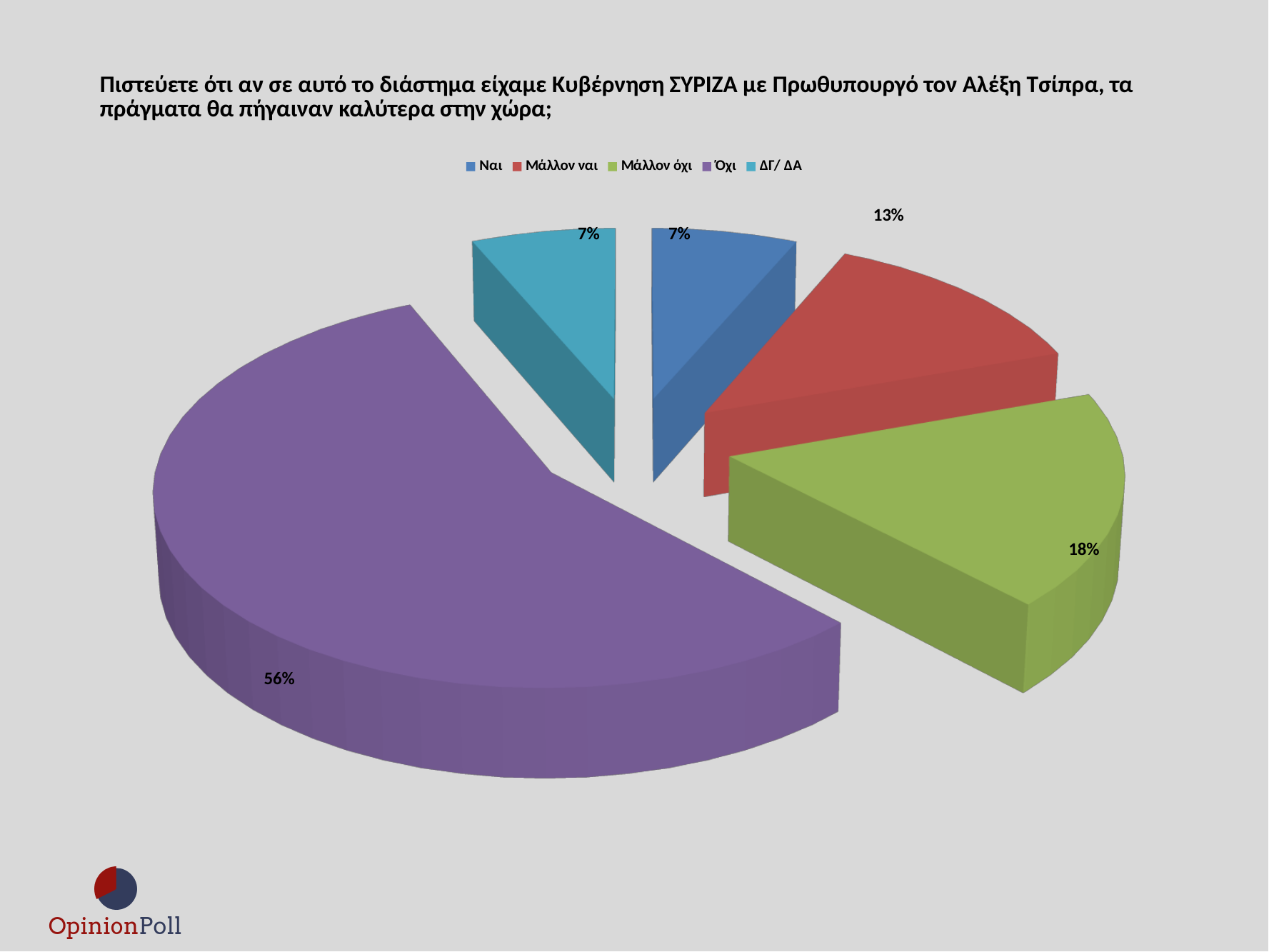
What percentage of respondents answered "Ναι"? 7% What kind of chart is shown on the slide? Pie chart What percentage of respondents answered "Μάλλον όχι"? 18% Which is larger, the share for "Μάλλον ναι" or the share for "Μάλλον όχι"? Μάλλον όχι What is the difference in percentage points between "Όχι" and "Μάλλον όχι"? 38 How many entries does the legend list? 5 What colour is the slice for "Όχι"? Purple What percentage of respondents answered "ΔΓ/ ΔΑ"? 7% What percentage of respondents answered "Όχι"? 56% Which response has the largest share of the pie? Όχι How many slices does the pie chart have? 5 What percentage of respondents answered "Μάλλον ναι"? 13%